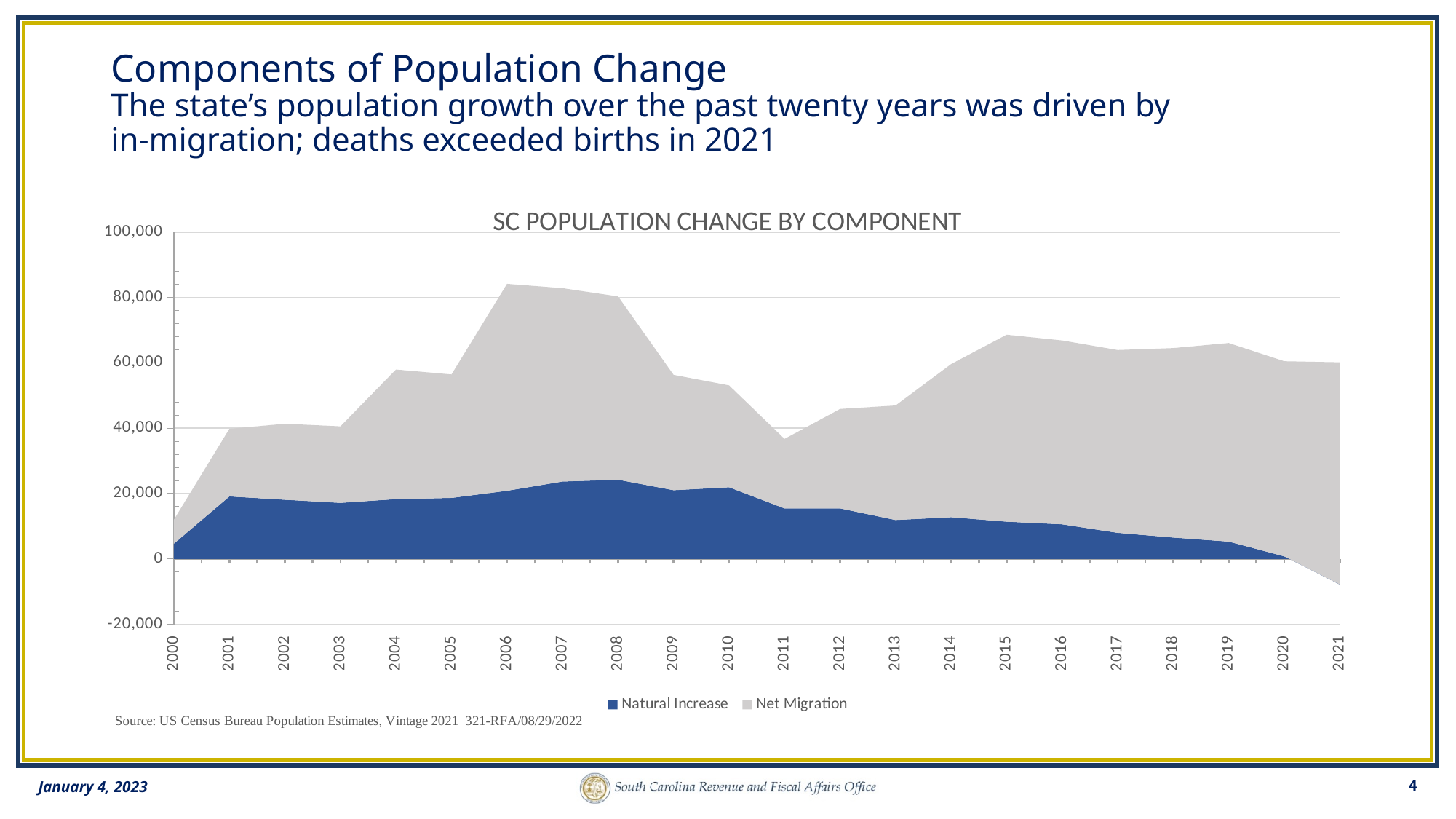
Is the combined total of the two components in 2011 greater or less than 40,000? less In which year is the combined total of Natural Increase and Net Migration highest? 2006 Does Natural Increase rise or fall from 2008 to 2021? fall What is the title of the chart? SC POPULATION CHANGE BY COMPONENT How many series does the legend list? 2 In which year is Natural Increase lowest? 2021 Is the combined total of the two components in 2006 greater or less than 80,000? greater How many years are shown along the x axis? 22 What kind of chart is shown on the slide? Area chart Is the Natural Increase value for 2021 greater or less than 0? less Which series is shown in grey? Net Migration Which year has the larger combined total, 2006 or 2015? 2006